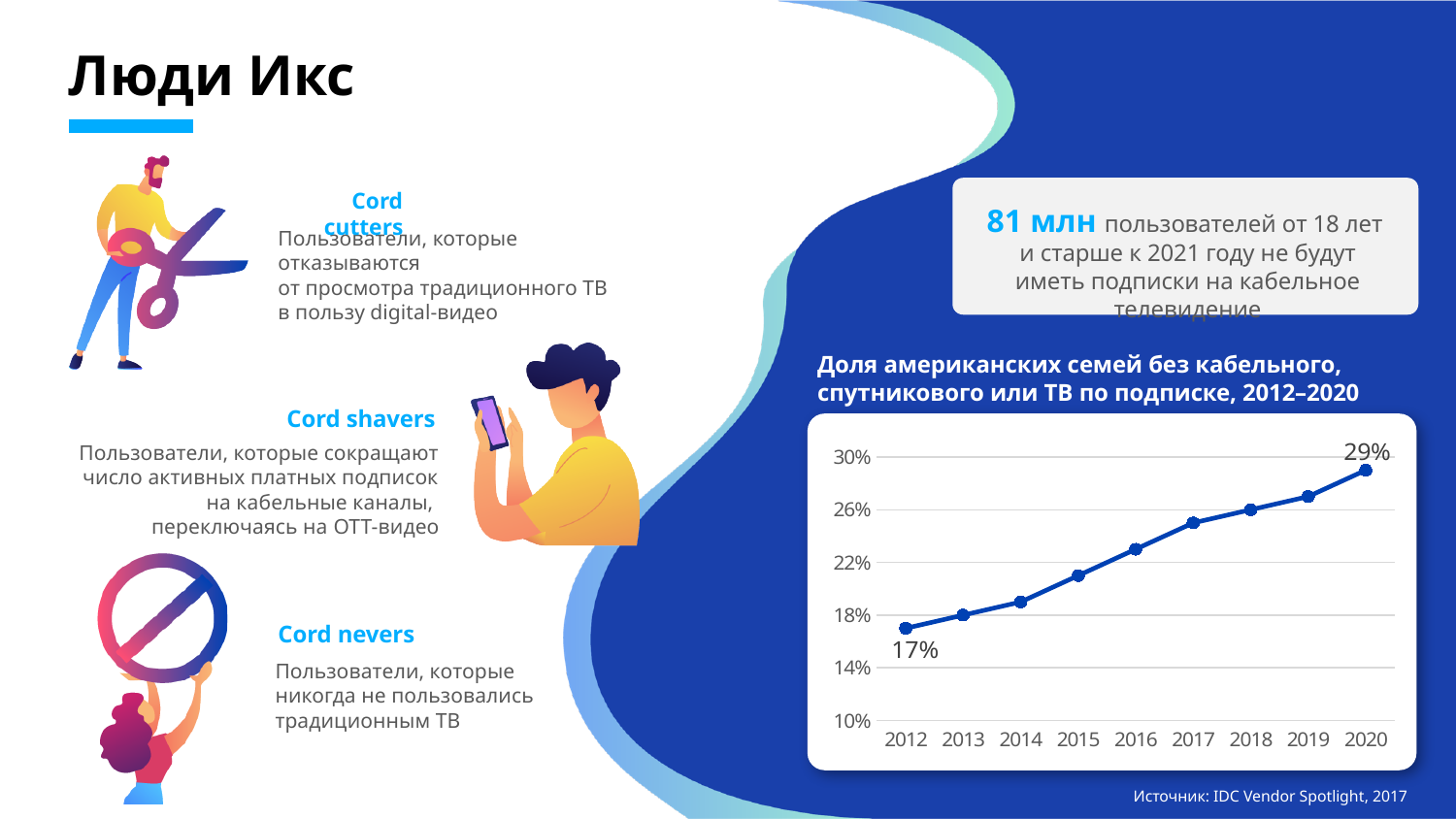
What kind of chart is shown on the slide? Line chart What is the value for 2012 in the chart 'Доля американских семей без кабельного, спутникового или ТВ по подписке, 2012–2020'? 17% Which year has the lowest value in the chart? 2012 How many years are plotted on the x axis of the chart? 9 Which year has the highest value in the chart? 2020 Do the values in the chart rise or fall from 2012 to 2020? Rise Which is larger, the value for 2012 or the value for 2020? 2020 Is the value for 2014 greater or less than 22%? less By how many percentage points does the 2020 value exceed the 2012 value in the chart? 12 percentage points Is the value for 2017 greater or less than 22%? greater What source is cited for the chart on the slide? IDC Vendor Spotlight, 2017 What is the value for 2020 in the chart? 29%